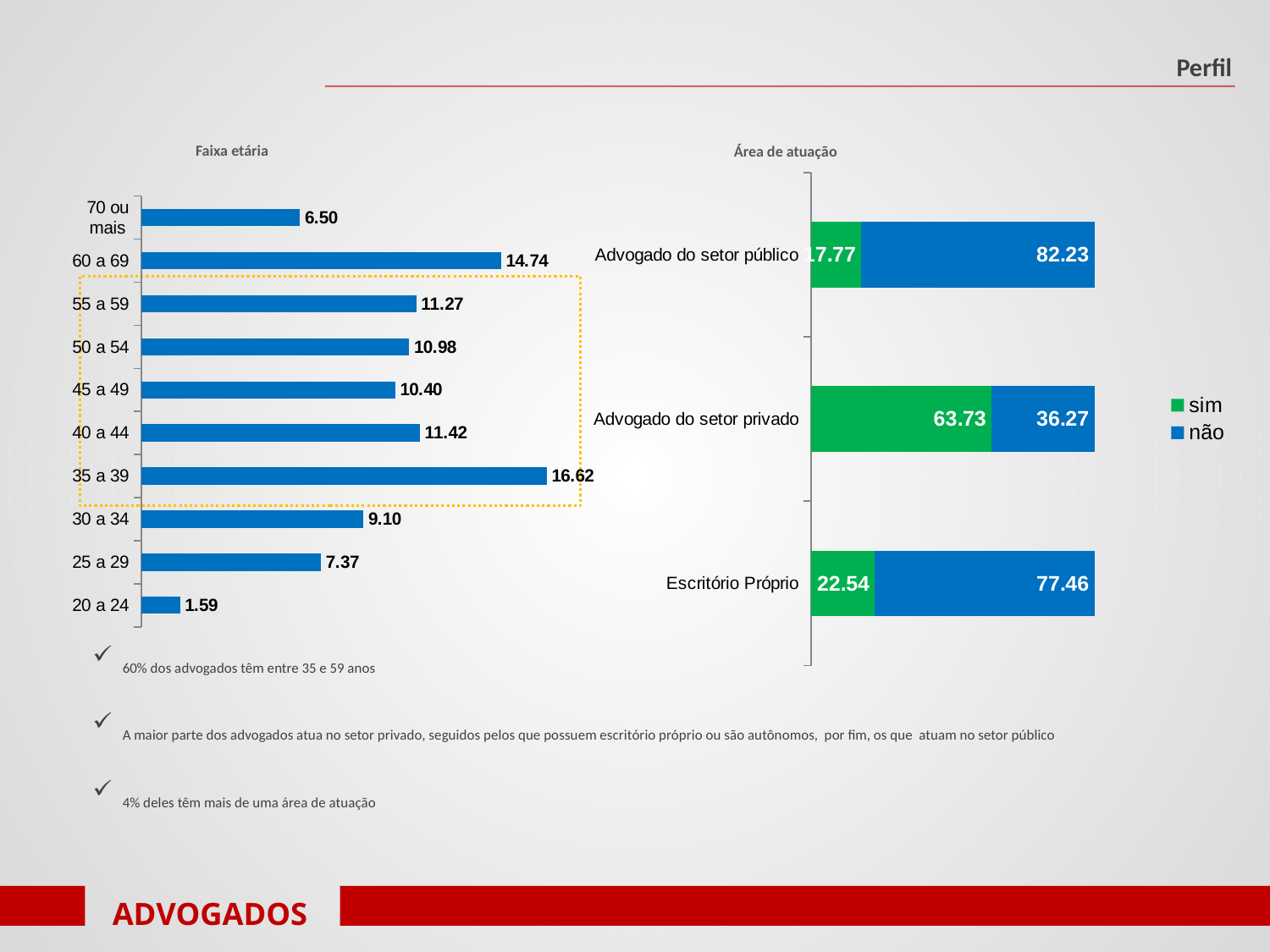
In the 'Faixa etária' chart, which age group has the lowest value? 20 a 24 In the 'Faixa etária' chart, which is larger, the value for 40 a 44 or the value for 45 a 49? 40 a 44 In the 'Faixa etária' chart, what is the value for the 35 a 39 age group? 16.62 In the 'Faixa etária' chart, what is the difference between the values for 60 a 69 and 70 ou mais? 8.24 What kind of chart is the 'Faixa etária' chart? Bar chart In the 'Faixa etária' chart, which age group has the highest value? 35 a 39 In the 'Faixa etária' chart, what is the value for the 60 a 69 age group? 14.74 In the 'Área de atuação' chart, what is the 'não' value for Advogado do setor privado? 36.27 In the 'Área de atuação' chart, which category has the highest 'sim' value? Advogado do setor privado How many series does the legend of the 'Área de atuação' chart list? 2 In the 'Área de atuação' chart, what is the 'sim' value for Escritório Próprio? 22.54 How many age groups are shown in the 'Faixa etária' chart? 10